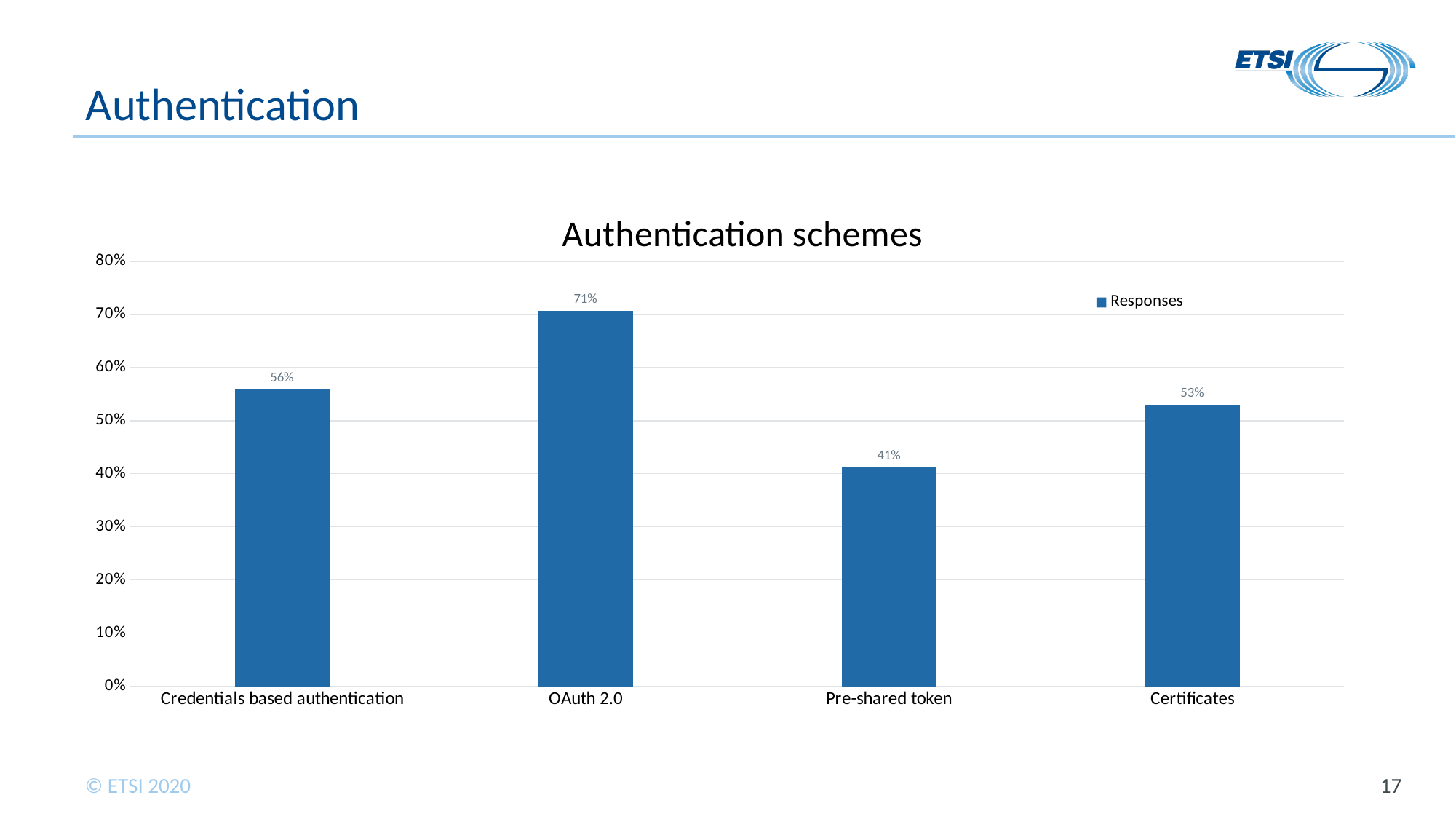
What is the value for Certificates? 53% Which authentication scheme has the highest value? OAuth 2.0 Which is larger, the value for Credentials based authentication or the value for Certificates? Credentials based authentication Which authentication scheme has the lowest value? Pre-shared token How many authentication schemes are shown on the chart? 4 What kind of chart is shown on the slide? Bar chart What is the value for Pre-shared token? 41% Is the value for Certificates greater or less than 50%? greater What is the value for Credentials based authentication? 56% What is the value for OAuth 2.0? 71% What is the title of the chart? Authentication schemes What is the difference between the values for OAuth 2.0 and Pre-shared token? 30%